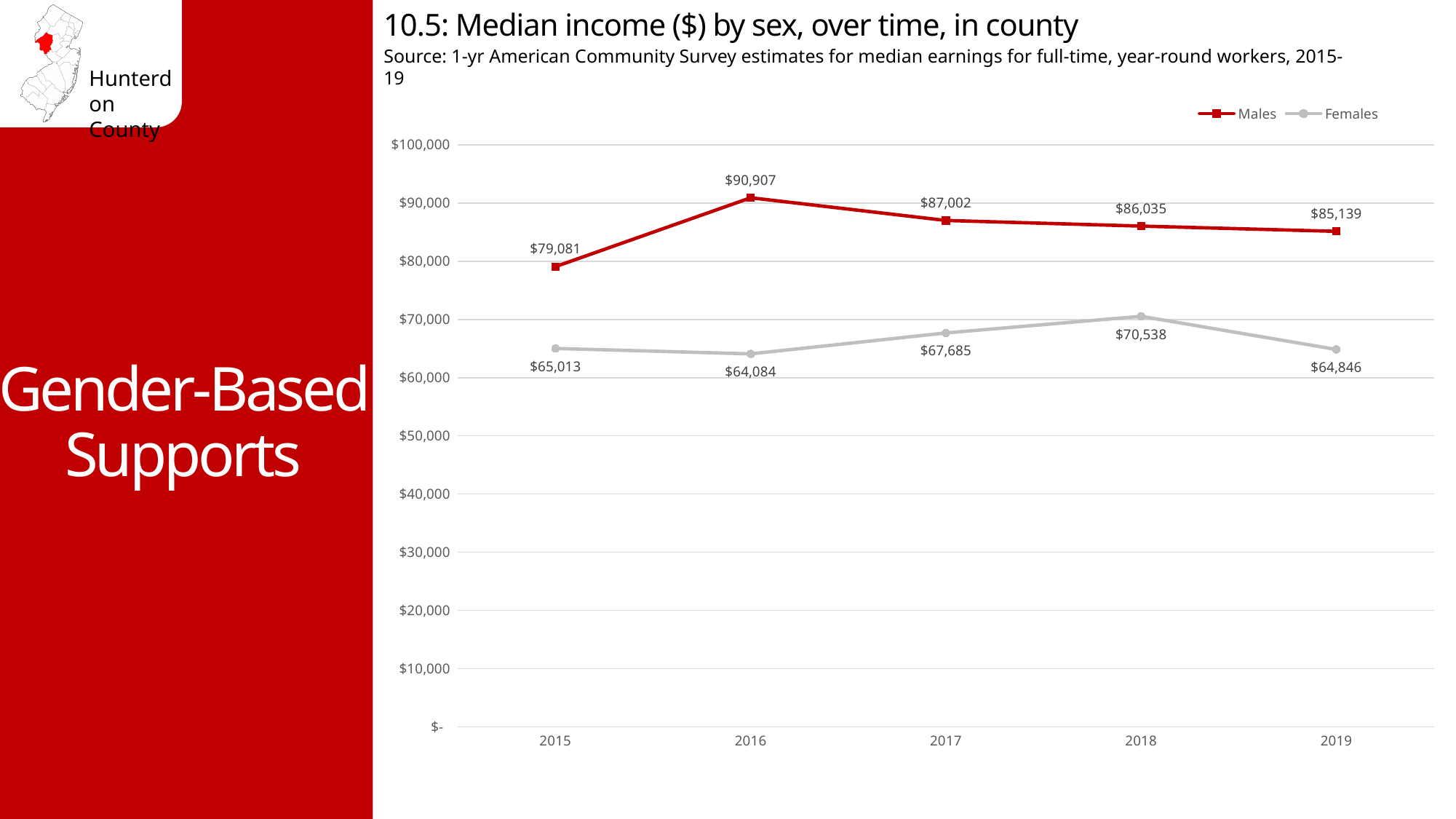
What kind of chart is shown on the slide? line chart Did the median income for Males rise or fall from 2016 to 2019? fall In which year was the median income for Females lowest? 2016 What was the median income for Males in 2016? $90,907 In which year was the median income for Males highest? 2016 How many series does the legend list? 2 How many years are shown on the x axis? 5 What was the median income for Females in 2018? $70,538 Which was larger in 2015: the median income for Males or for Females? Males What was the median income for Males in 2019? $85,139 What is the difference between the Males and Females median income in 2017? $19,317 Is the median income for Females in 2019 greater or less than $70,000? less